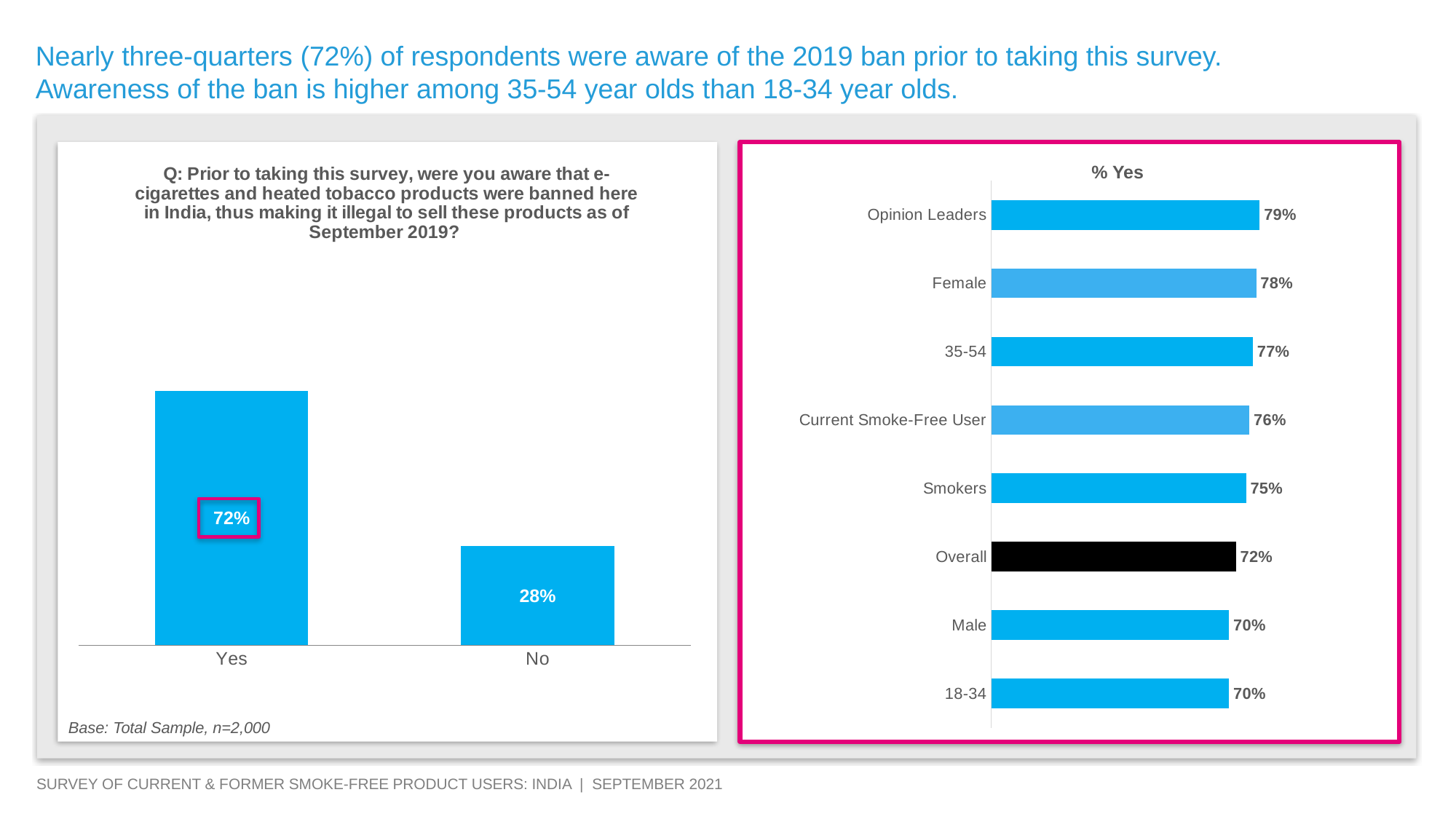
What kind of chart is the left chart? Bar chart In the left chart, what percentage of respondents answered Yes? 72% In the '% Yes' chart on the right, which category has the highest value? Opinion Leaders In the '% Yes' chart on the right, what is the difference between the values for 35-54 and 18-34? 7% In the '% Yes' chart on the right, how many categories are shown? 8 In the left chart, how many categories are shown on the x axis? 2 In the '% Yes' chart on the right, which is larger, the value for Female or the value for Male? Female In the left chart, what is the difference between the Yes and No percentages? 44% In the left chart, what percentage of respondents answered No? 28% In the '% Yes' chart on the right, what is the value for Opinion Leaders? 79% In the '% Yes' chart on the right, which category's bar is coloured black? Overall In the '% Yes' chart on the right, what is the value for Current Smoke-Free User? 76%